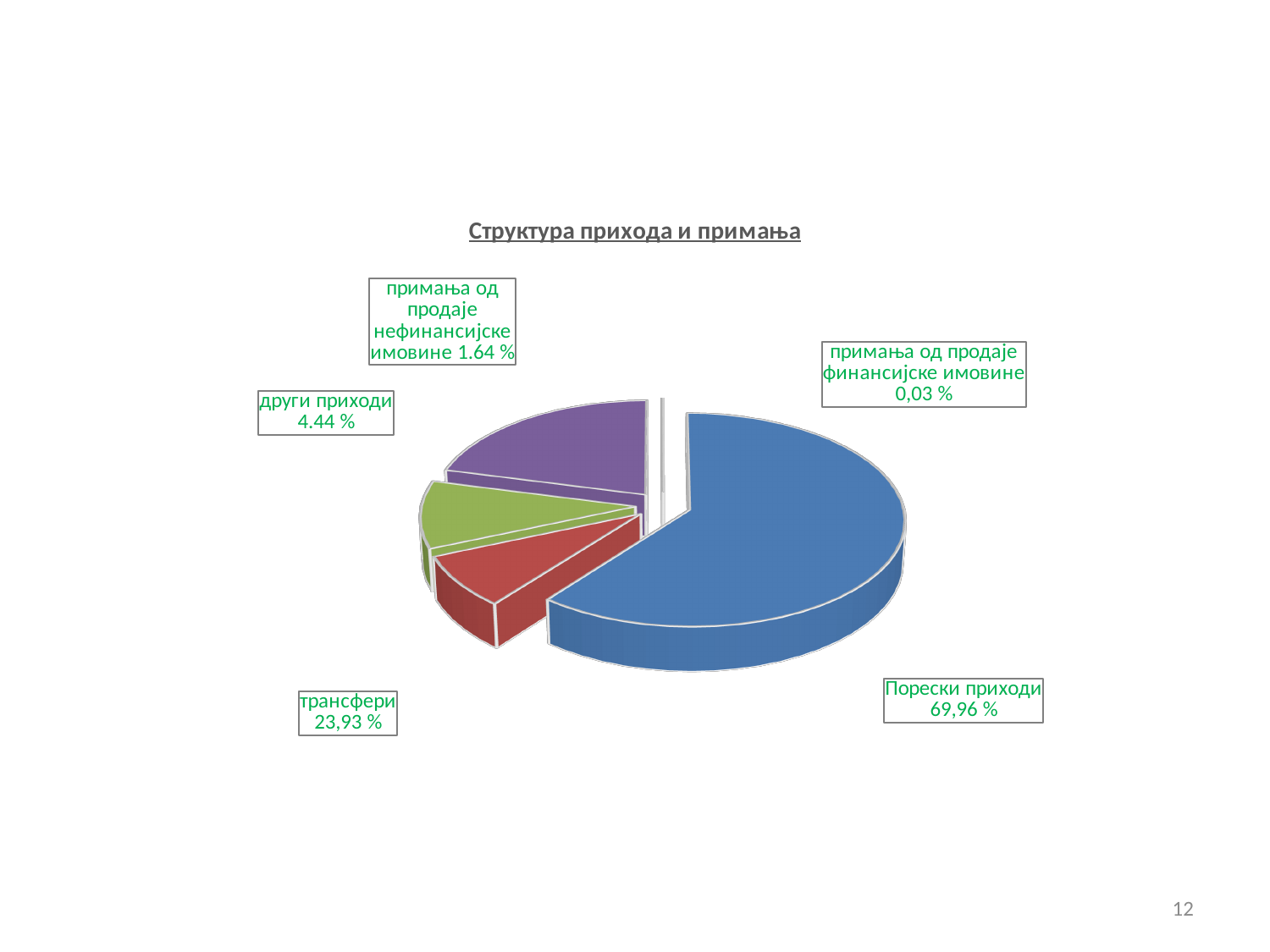
What is the value shown for трансфери? 23,93 % What is the value shown for други приходи? 4.44 % What kind of chart is shown on the slide? Pie chart Which category has the smallest share of the pie? примања од продаје финансијске имовине How many slices does the pie chart have? 5 What share of the pie is Порески приходи? 69,96 % Which category has the largest share of the pie? Порески приходи What is the value shown for примања од продаје нефинансијске имовине? 1.64 % Which is larger, the share of трансфери or the share of други приходи? трансфери What is the difference between the shares of Порески приходи and трансфери? 46,03 % What is the title of the chart? Структура прихода и примања What is the value shown for примања од продаје финансијске имовине? 0,03 %